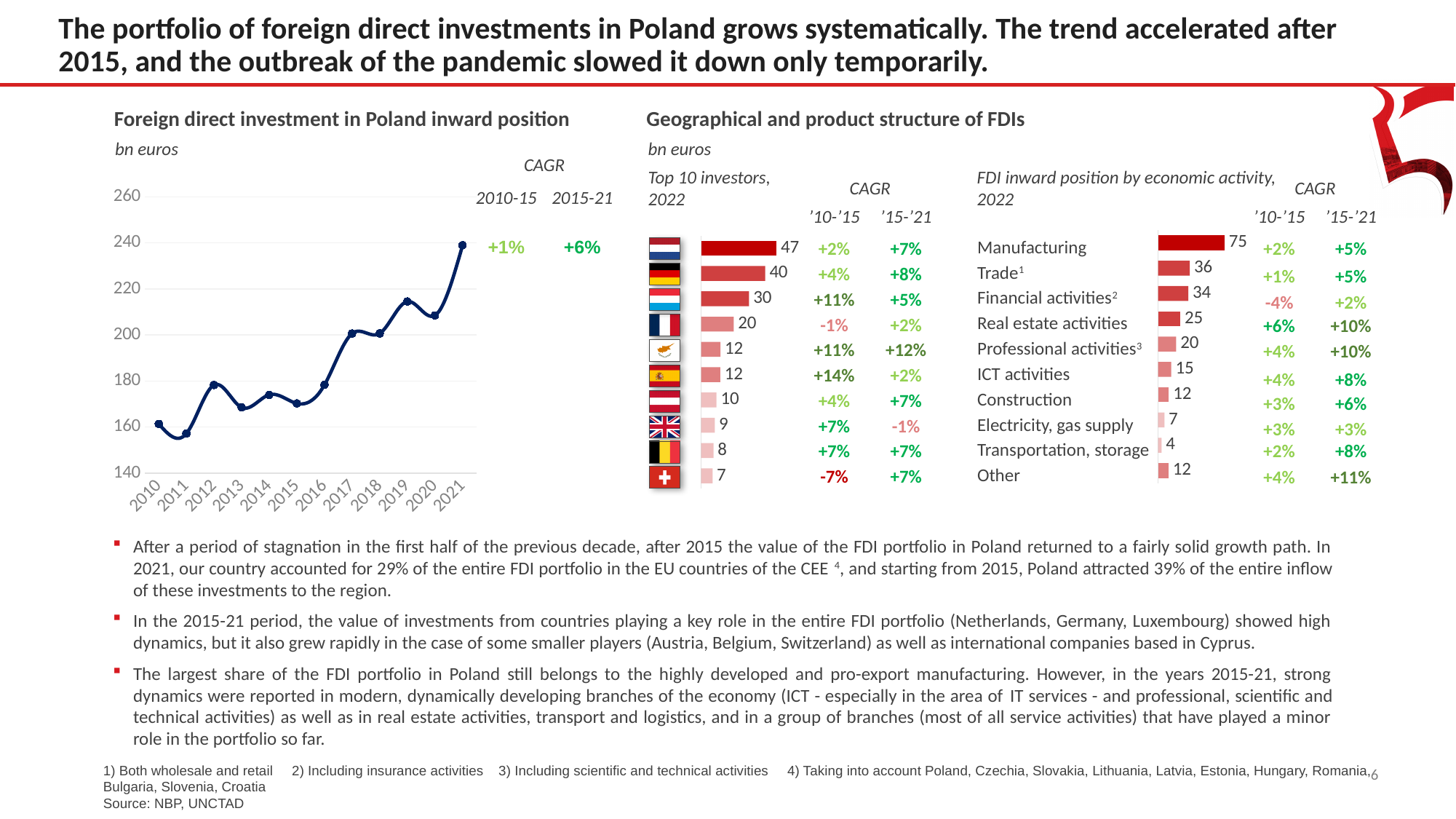
In the 'Top 10 investors, 2022' chart, what is the value of the longest bar? 47 In the 'FDI inward position by economic activity, 2022' chart, what is the value for Manufacturing? 75 In the 'Foreign direct investment in Poland inward position' chart, what CAGR is shown for 2015-21? +6% In the 'Foreign direct investment in Poland inward position' chart, do the values overall rise or fall from 2010 to 2021? rise In the 'Foreign direct investment in Poland inward position' chart, how many years are shown on the x axis? 12 In the 'Foreign direct investment in Poland inward position' chart, is the value for 2011 greater or less than 160? less In the 'FDI inward position by economic activity, 2022' chart, which is larger: Real estate activities or ICT activities? Real estate activities What kind of chart is 'Foreign direct investment in Poland inward position'? line chart In the 'FDI inward position by economic activity, 2022' chart, which activity has the lowest value? Transportation, storage In the 'FDI inward position by economic activity, 2022' chart, what is the difference between Manufacturing and Trade? 39 In the 'FDI inward position by economic activity, 2022' chart, how many activity categories are shown? 10 In the 'Foreign direct investment in Poland inward position' chart, is the value for 2021 greater or less than 220? greater